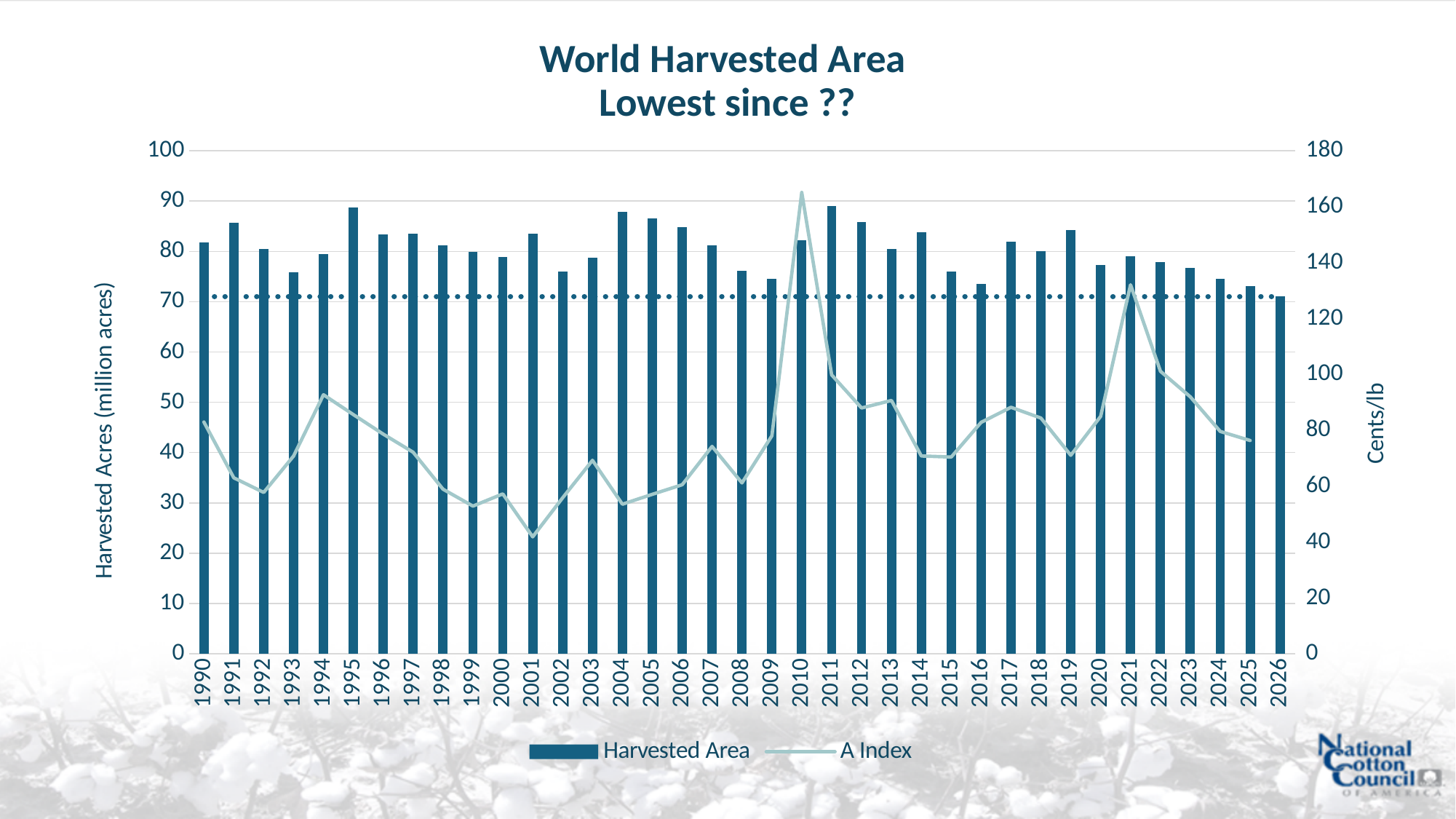
In which year is the A Index at its lowest value? 2001 How many years are shown along the x axis? 37 What is the label on the right-hand vertical axis? Cents/lb Is the A Index value for 2001 greater or less than 60? less How many series does the legend list? 2 Does the A Index rise or fall from 2021 to 2025? Fall What kind of chart is shown on the slide? A combination bar and line chart In which year does the A Index reach its highest value? 2010 Is the Harvested Area value for 2002 greater or less than 80? less Is the A Index value for 2010 greater or less than 140? greater Which year has the larger Harvested Area, 2004 or 2008? 2004